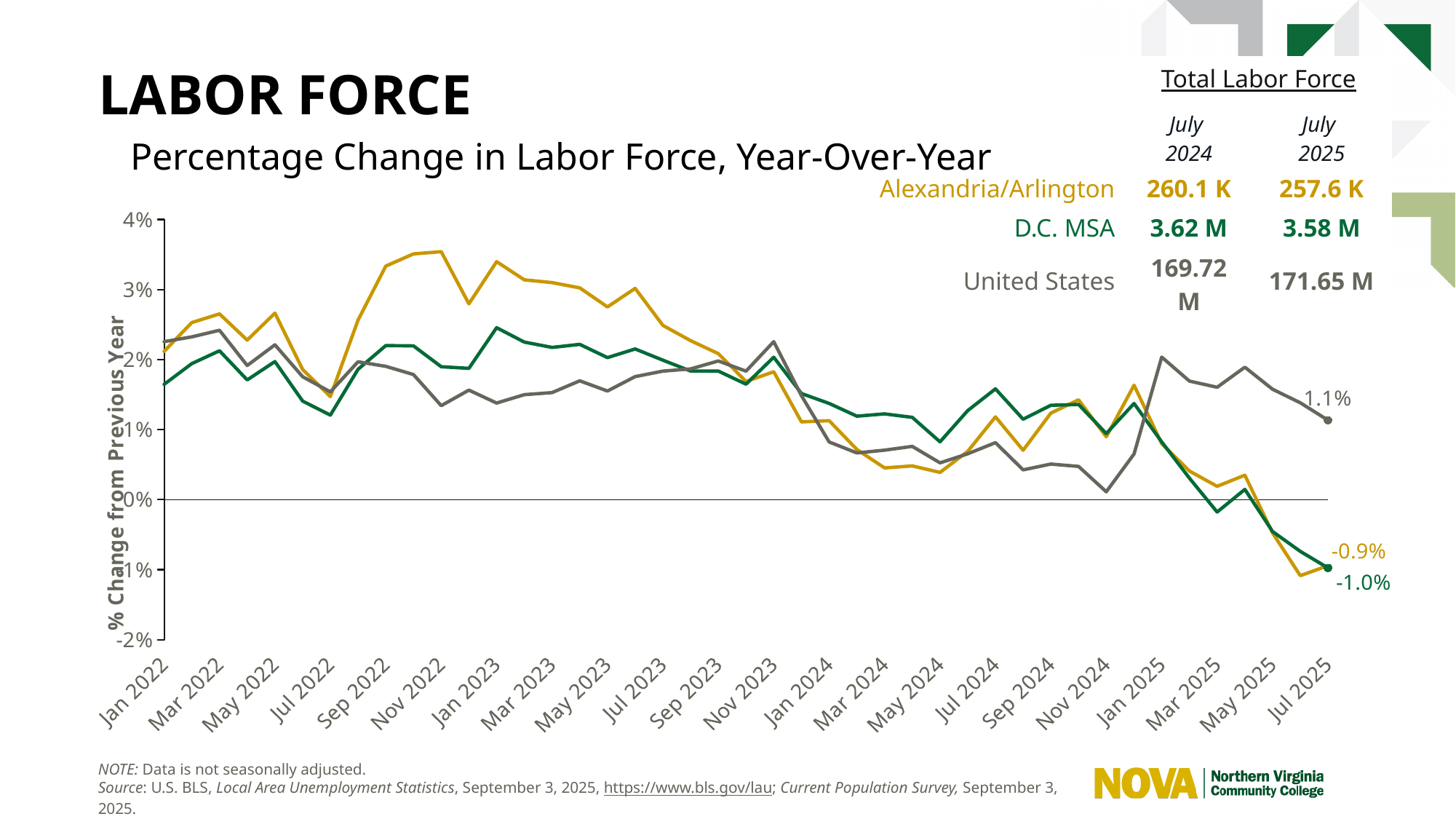
What is the year-over-year percentage change in labor force for the United States in Jul 2025? 1.1% In Jul 2025, which series has the lowest value? D.C. MSA What is the title of the chart's vertical axis? % Change from Previous Year In Jul 2025, which series has the highest value: Alexandria/Arlington, D.C. MSA, or United States? United States What is the difference between the United States value and the Alexandria/Arlington value in Jul 2025? 2.0 percentage points What is the year-over-year percentage change in labor force for the D.C. MSA in Jul 2025? -1.0% Is the value for Alexandria/Arlington in Nov 2022 greater or less than 3%? greater Does the Alexandria/Arlington line rise or fall between Jan 2025 and Jul 2025? fall How many series are plotted in the chart? 3 What kind of chart is shown on the slide? line chart What is the year-over-year percentage change in labor force for Alexandria/Arlington in Jul 2025? -0.9% Is the value for the United States in Jan 2023 greater or less than 2%? less